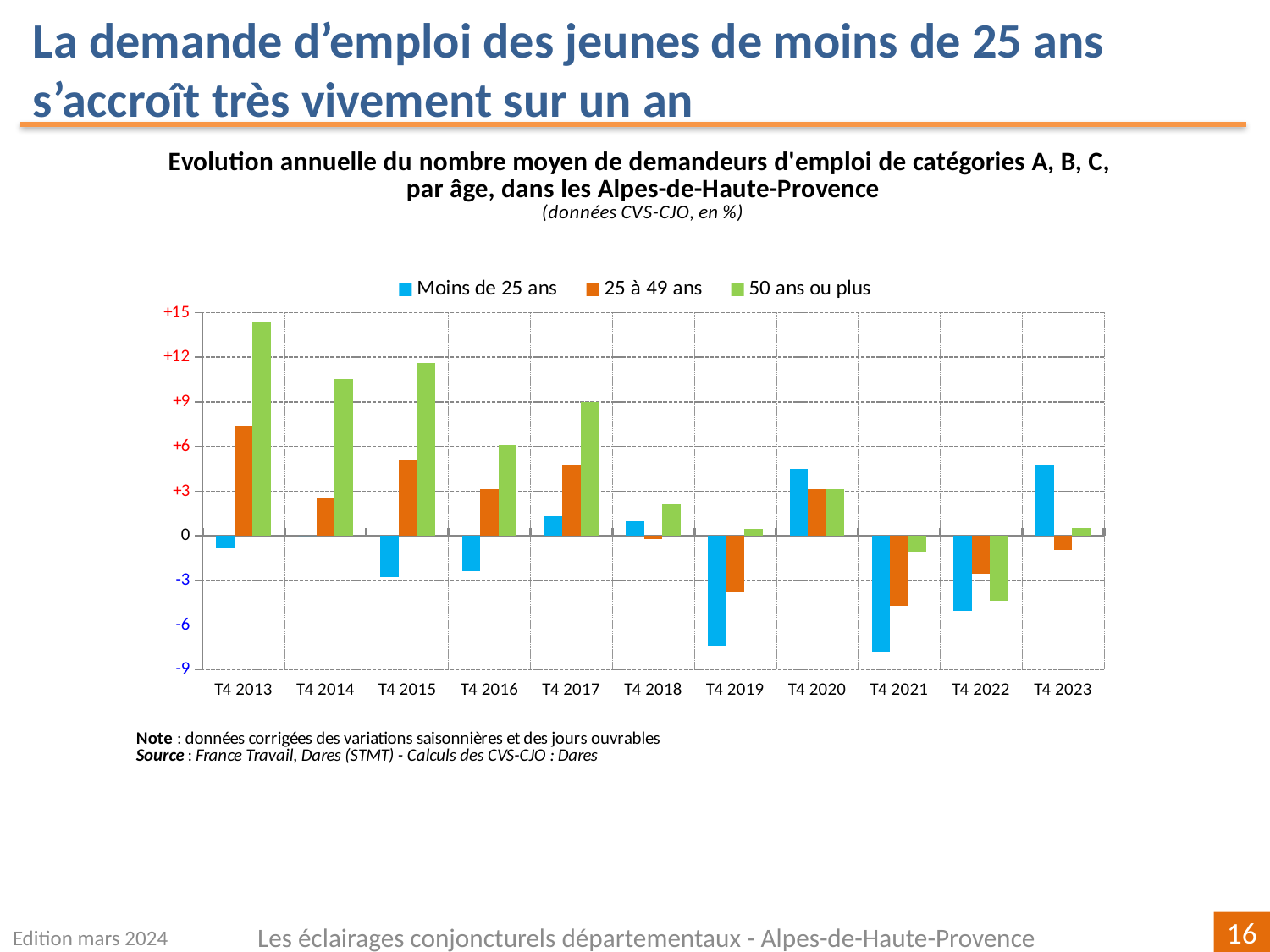
In T4 2017, which is larger: the value for '25 à 49 ans' or for '50 ans ou plus'? 50 ans ou plus How many series does the legend list? 3 For the series '25 à 49 ans', which quarter has the highest value? T4 2013 Is the value for 'Moins de 25 ans' in T4 2019 greater or less than -6? less Is the value for '50 ans ou plus' in T4 2015 greater or less than +9? greater What kind of chart is shown on the slide? Bar chart For the series '50 ans ou plus', which quarter has the highest value? T4 2013 Is the value for '50 ans ou plus' in T4 2013 greater or less than +12? greater In T4 2023, which is larger: the value for 'Moins de 25 ans' or for '25 à 49 ans'? Moins de 25 ans Which colour represents the series 'Moins de 25 ans' in the legend? Blue How many quarters (categories) are shown on the x axis? 11